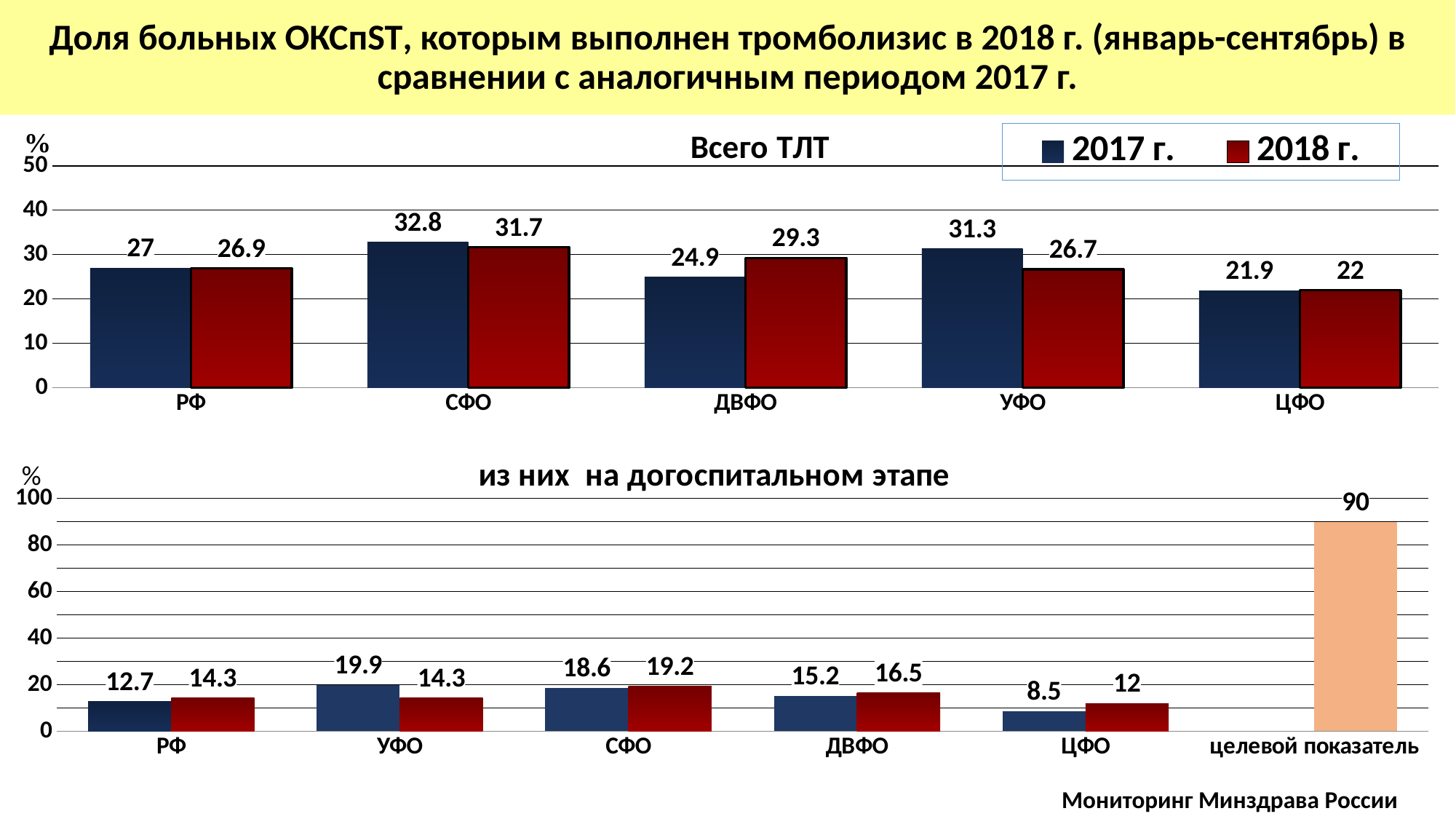
How many series does the legend of the top chart 'Всего ТЛТ' list? 2 In the top chart 'Всего ТЛТ', what is the value for СФО in 2017 г.? 32.8 In the bottom chart 'из них на догоспитальном этапе', what is the value of the 'целевой показатель' bar? 90 In the bottom chart 'из них на догоспитальном этапе', what is the value for ЦФО in 2017 г.? 8.5 In the top chart 'Всего ТЛТ', what is the value for ДВФО in 2018 г.? 29.3 In the top chart 'Всего ТЛТ', what is the difference between the 2017 г. and 2018 г. values for УФО? 4.6 What type of chart is the top chart 'Всего ТЛТ'? Bar chart How many categories are shown on the x axis of the bottom chart 'из них на догоспитальном этапе'? 6 In the top chart 'Всего ТЛТ', which is larger for ДВФО: the 2017 г. value or the 2018 г. value? 2018 г. In the top chart 'Всего ТЛТ', which category has the highest 2017 г. value? СФО In the bottom chart 'из них на догоспитальном этапе', what is the difference between the 2017 г. and 2018 г. values for УФО? 5.6 In the top chart 'Всего ТЛТ', which category has the lowest 2018 г. value? ЦФО